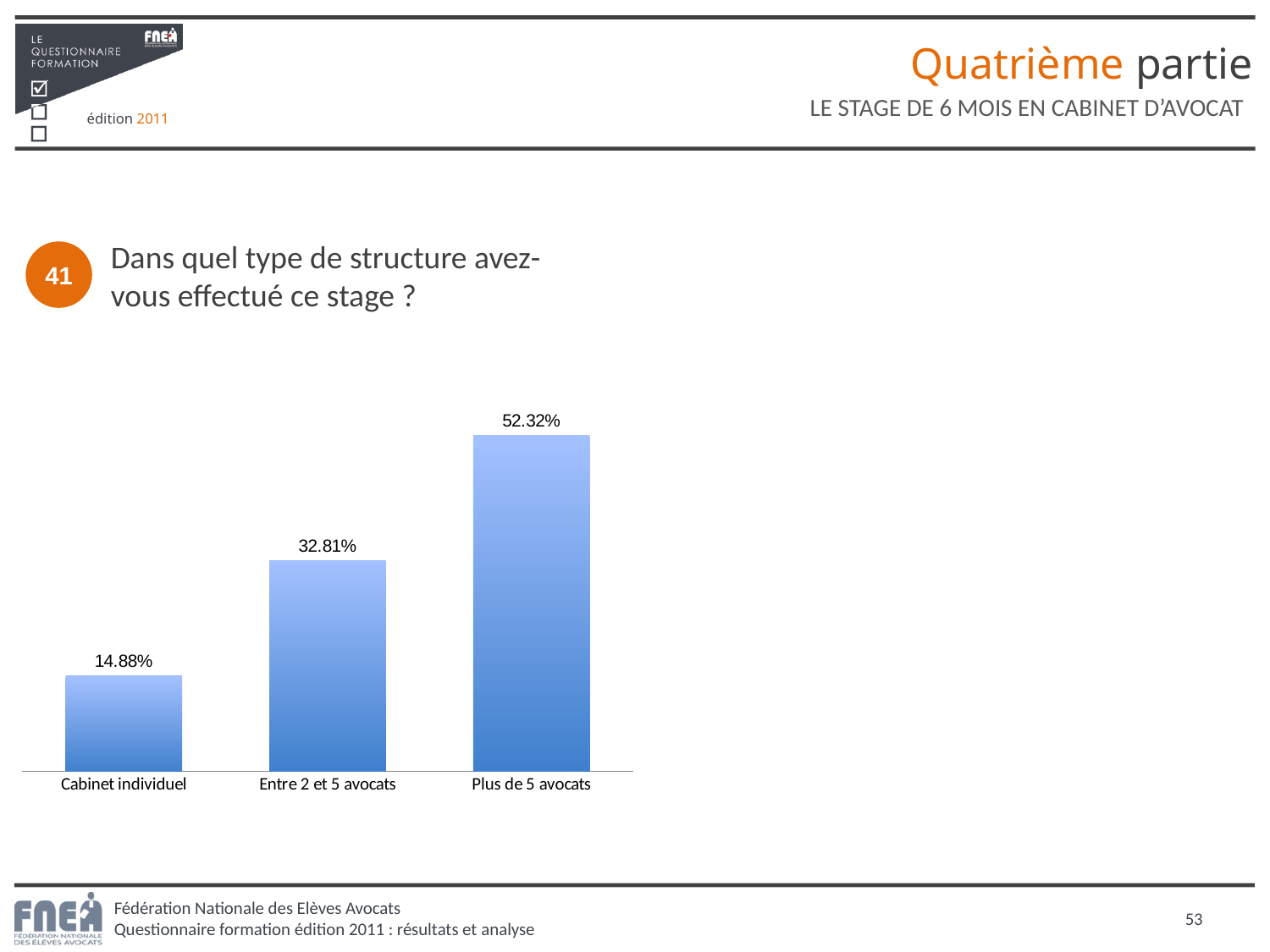
Which is larger, the value for Cabinet individuel or the value for Entre 2 et 5 avocats? Entre 2 et 5 avocats What is the value for Plus de 5 avocats? 52.32% How many categories are shown on the x axis? 3 What question does the chart on the slide answer? Dans quel type de structure avez-vous effectué ce stage ? Which category has the highest value? Plus de 5 avocats What is the difference between the values for Entre 2 et 5 avocats and Cabinet individuel? 17.93% What kind of chart is shown on the slide? bar chart What is the difference between the values for Plus de 5 avocats and Entre 2 et 5 avocats? 19.51% Do the values rise or fall from left to right along the x axis? rise What is the value for Entre 2 et 5 avocats? 32.81% What is the value for Cabinet individuel? 14.88% Which category has the lowest value? Cabinet individuel